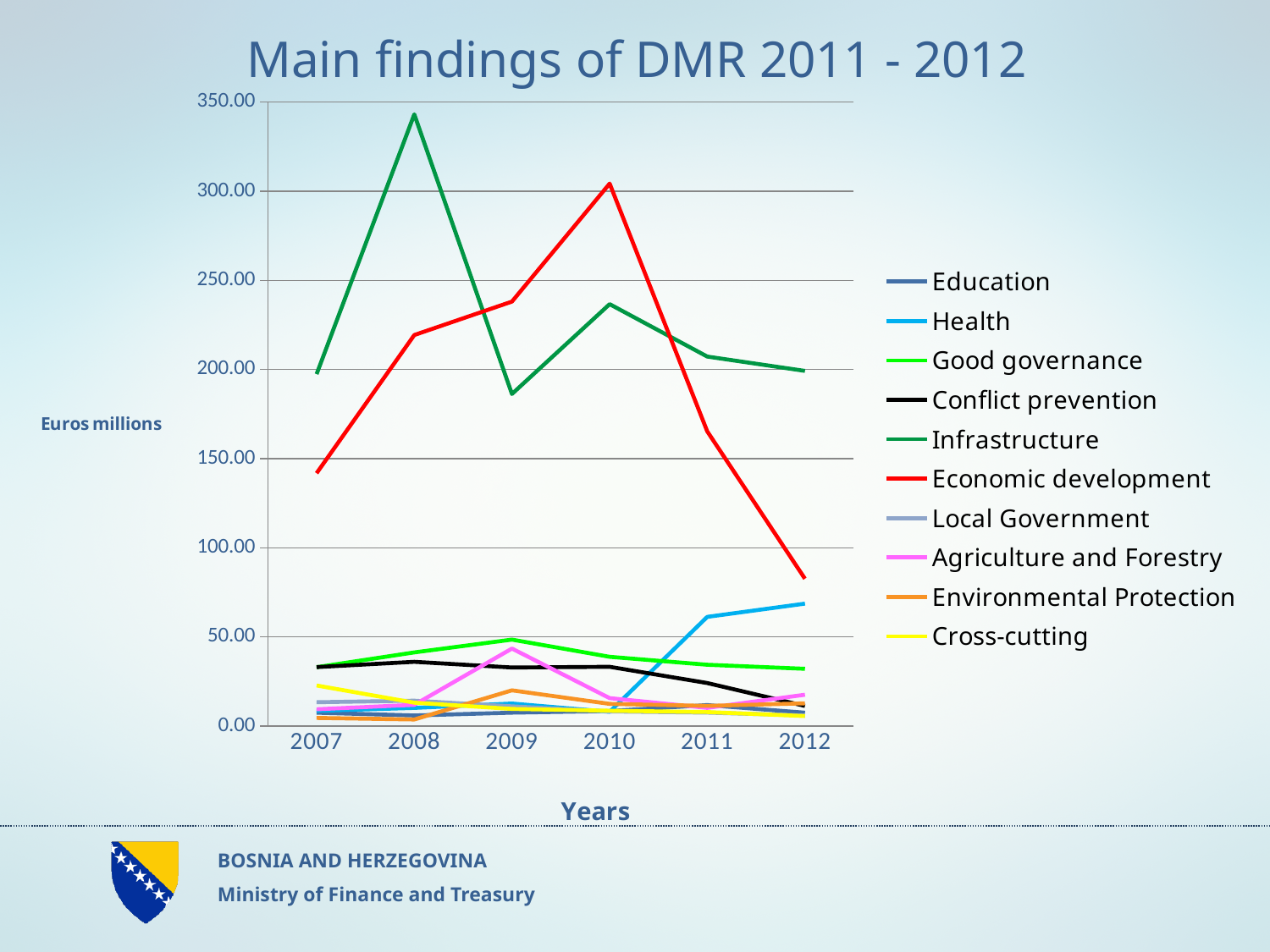
Is the Health value in 2011 greater or less than 50.00? greater What kind of chart is shown on the slide? line chart In 2007, which is larger: Infrastructure or Economic development? Infrastructure How many series does the legend list? 10 In which year does the Infrastructure line reach its highest value? 2008 In which year is the Economic development value lowest? 2012 What is the label on the vertical axis? Euros millions Is the Infrastructure value in 2008 greater or less than 300.00? greater In which year does the Economic development line reach its highest value? 2010 Is the Economic development value in 2012 greater or less than 100.00? less How many years are shown on the x axis? 6 Does the Economic development line rise or fall from 2010 to 2012? fall